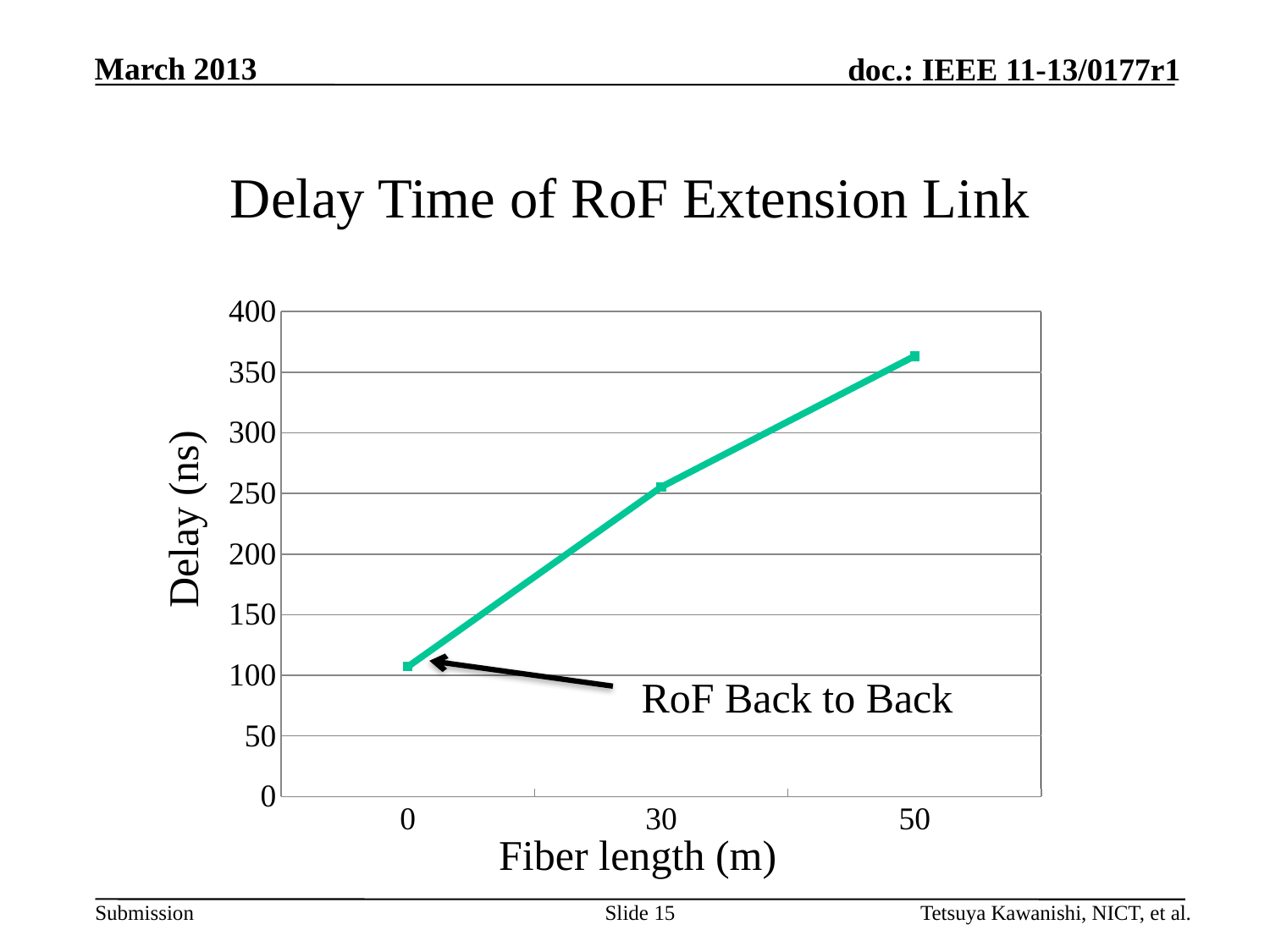
Does the delay rise or fall as fiber length increases along the x axis? rise Which has the larger delay, a fiber length of 30 m or 50 m? 50 Is the delay at a fiber length of 30 m greater or less than 300 ns? less What is the title of the chart? Delay Time of RoF Extension Link What is the label of the y axis? Delay (ns) How many data points are plotted on the line? 3 What kind of chart is shown on the slide? line chart Is the delay at a fiber length of 0 m greater or less than 150 ns? less Is the delay at a fiber length of 30 m greater or less than 200 ns? greater Which fiber length has the lowest delay? 0 Which fiber length has the highest delay? 50